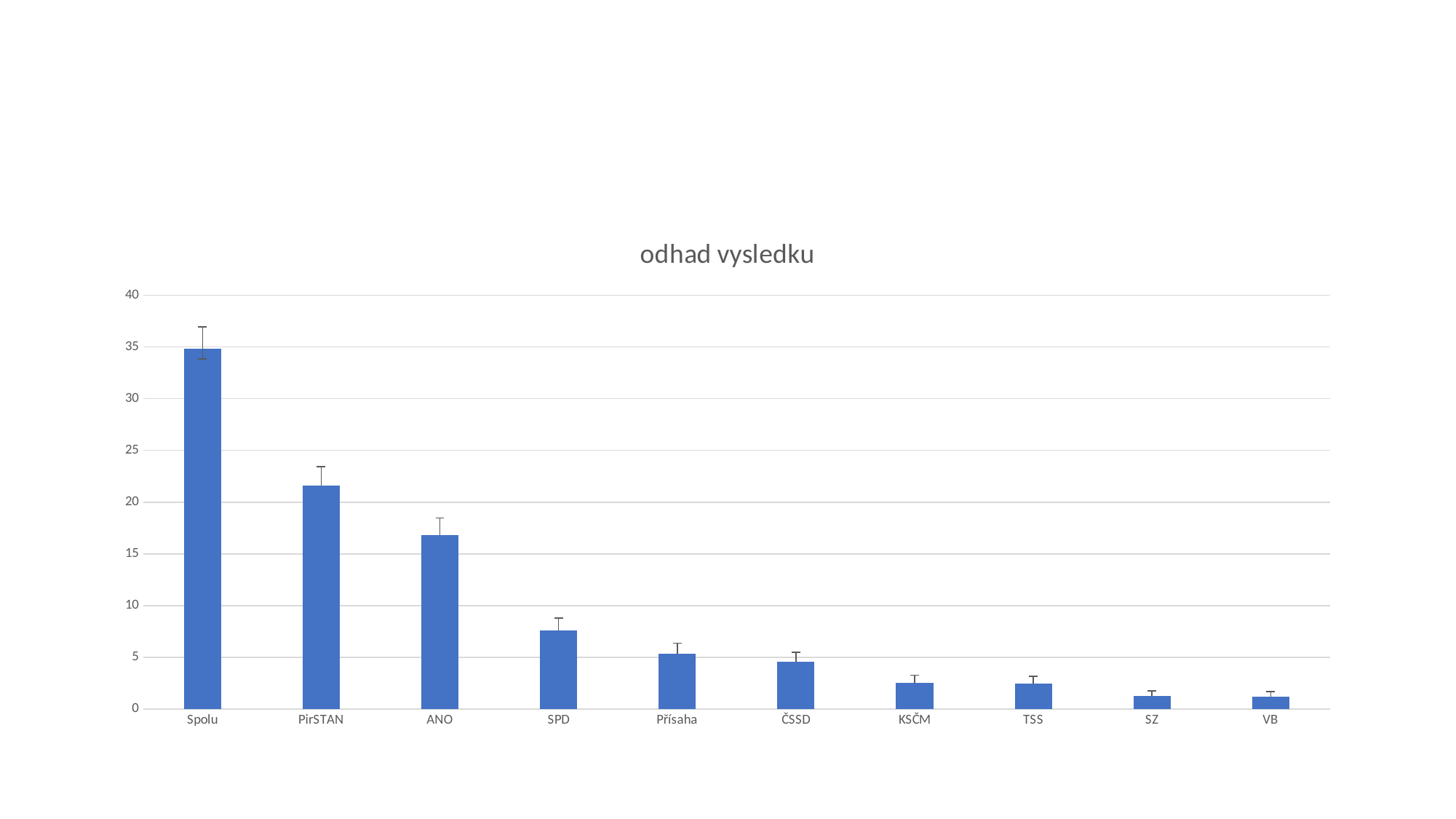
Is the value for Spolu greater or less than 30? greater Do the bar values rise or fall from left to right along the x axis? fall What kind of chart is shown on the slide? bar chart How many categories are shown on the x axis of the chart? 10 Is the value for PirSTAN greater or less than 25? less Which category has the highest value in the chart? Spolu Is the value for ANO greater or less than 15? greater Which has a larger value, PirSTAN or ANO? PirSTAN Which has a larger value, SPD or ČSSD? SPD What is the title of the chart? odhad vysledku